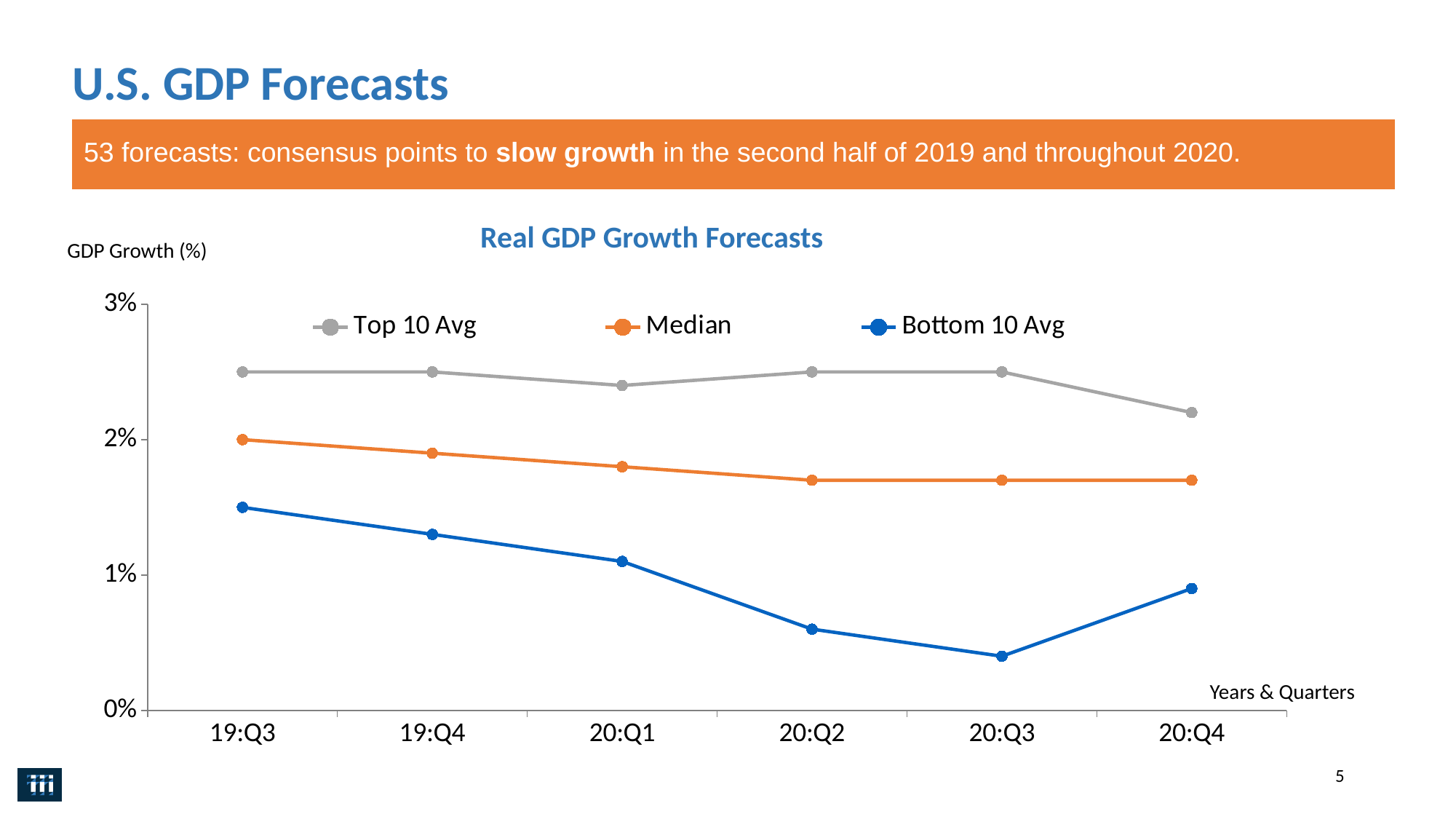
How many quarters are plotted along the x axis? 6 Is the Median value for 20:Q2 greater or less than 2%? less What is the title of the chart? Real GDP Growth Forecasts What is the label on the x axis? Years & Quarters Is the Bottom 10 Avg value for 20:Q3 greater or less than 1%? less Does the Median series rise or fall from 19:Q3 to 20:Q2? Fall In which quarter is the Bottom 10 Avg series at its lowest? 20:Q3 Is the Top 10 Avg value for 20:Q4 greater or less than 2%? greater In which quarter is the Top 10 Avg series at its lowest? 20:Q4 What kind of chart is shown on the slide? Line chart How many series does the legend list? 3